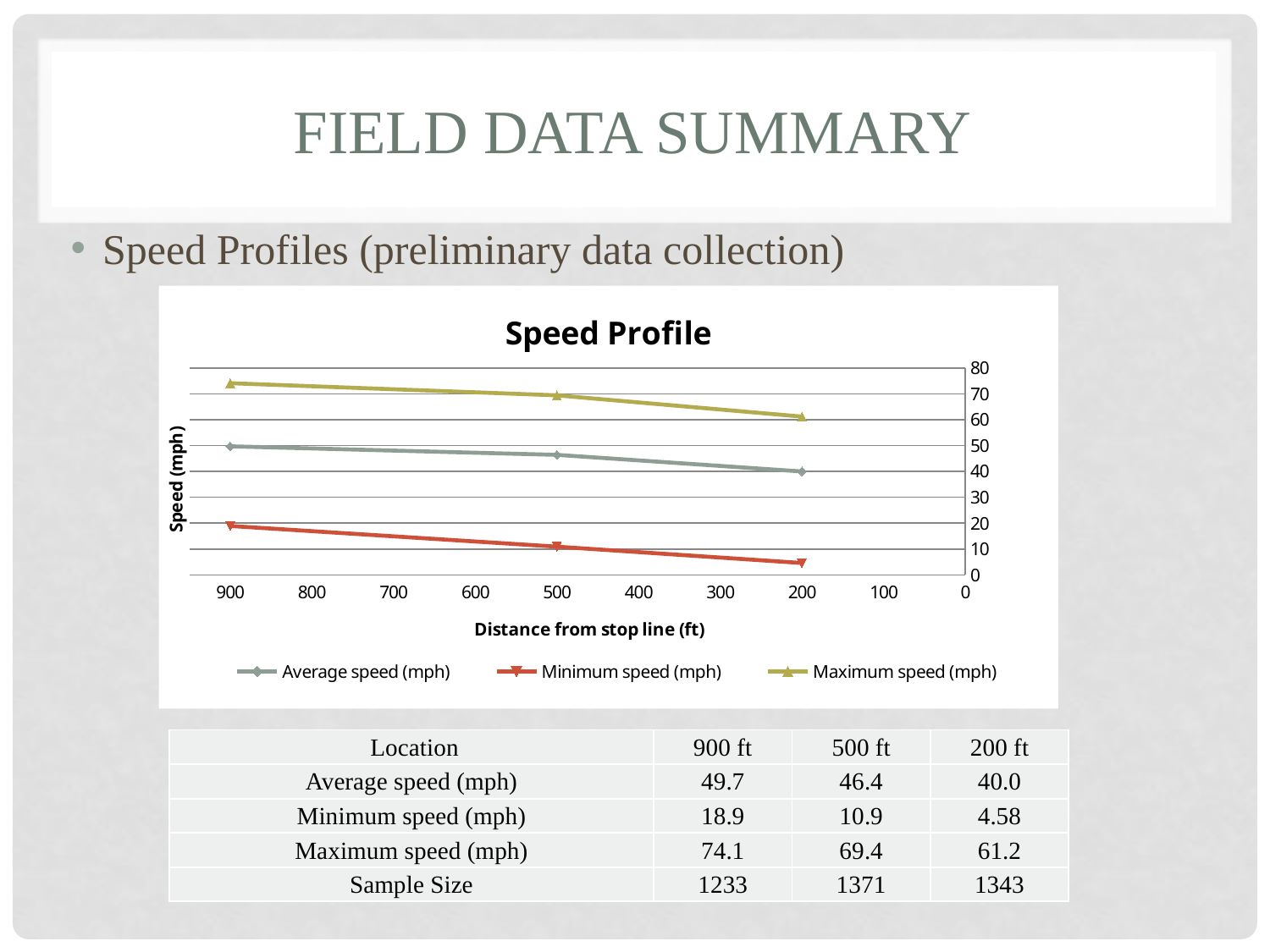
What is the average speed at 900 ft from the stop line? 49.7 What is the label of the y axis in the Speed Profile chart? Speed (mph) What is the maximum speed at 200 ft from the stop line? 61.2 Which series has the highest values in the Speed Profile chart? Maximum speed (mph) Is the average speed at 500 ft greater or less than the average speed at 200 ft? greater What kind of chart is the Speed Profile chart? line chart Do the speeds rise or fall as the distance from the stop line decreases from 900 ft to 200 ft? fall What is the difference between the maximum speed and the average speed at 900 ft? 24.4 How many series does the legend of the Speed Profile chart list? 3 Is the maximum speed at 500 ft greater or less than 60? greater At which distance from the stop line is the minimum speed lowest? 200 ft What is the minimum speed at 500 ft from the stop line? 10.9